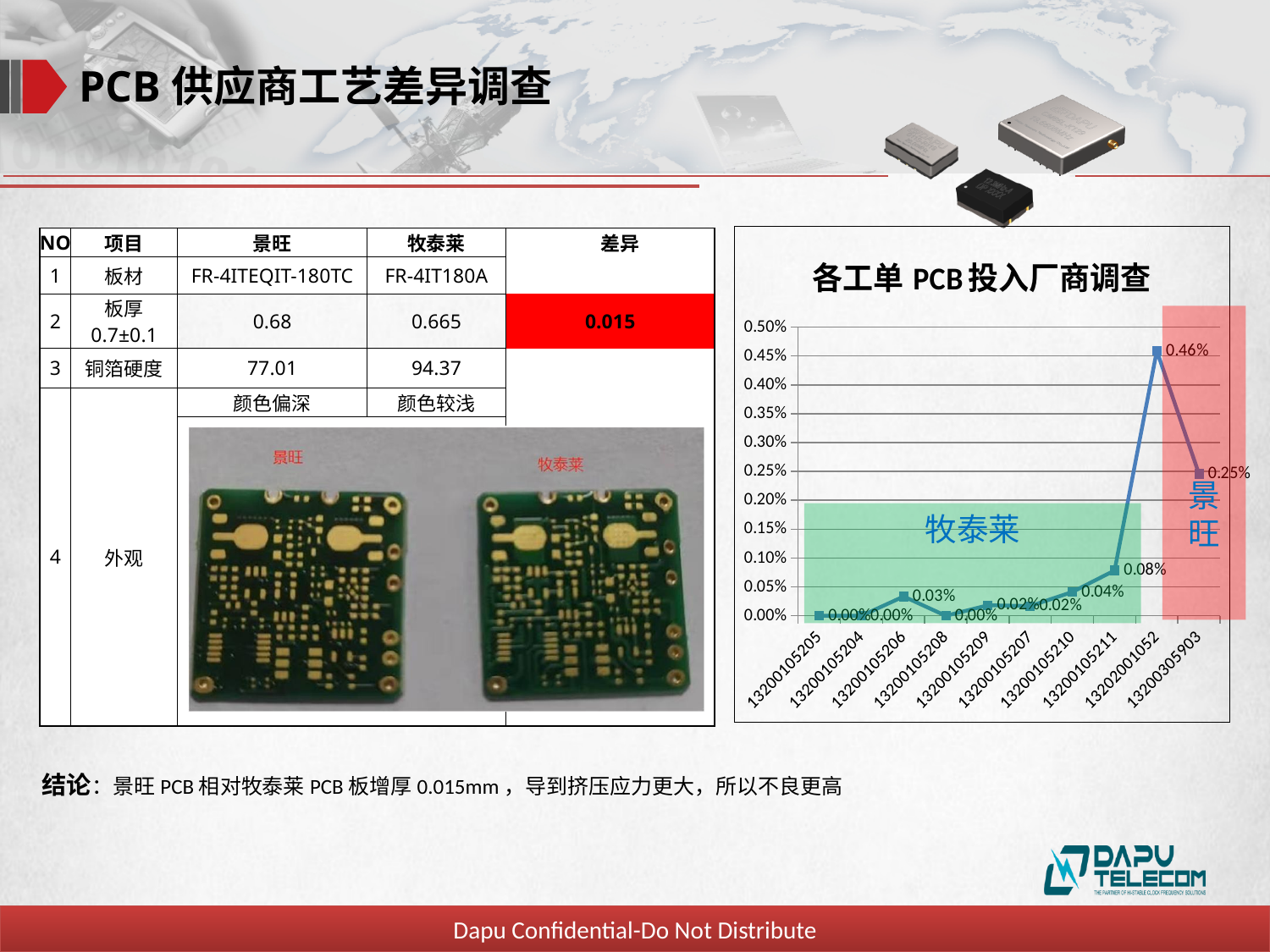
What type of chart is shown on the right side of the slide? line chart How many work orders (categories) are plotted on the x axis of the chart? 10 What is the value for work order 13202001052 in the chart? 0.46% What is the difference between the values for 13202001052 and 13200305903? 0.21% What is the title of the chart on the slide? 各工单 PCB 投入厂商调查 What is the value for work order 13200105211 in the chart? 0.08% Which is larger in the chart, the value for 13200105211 or the value for 13200105210? 13200105211 What is the value for work order 13200305903 in the chart? 0.25% What is the value for work order 13200105206 in the chart? 0.03% Which work order has the highest value in the chart? 13202001052 Is the value for 13202001052 greater or less than 0.40%? greater Which supplier name is shown in the red shaded region on the right of the chart? 景旺